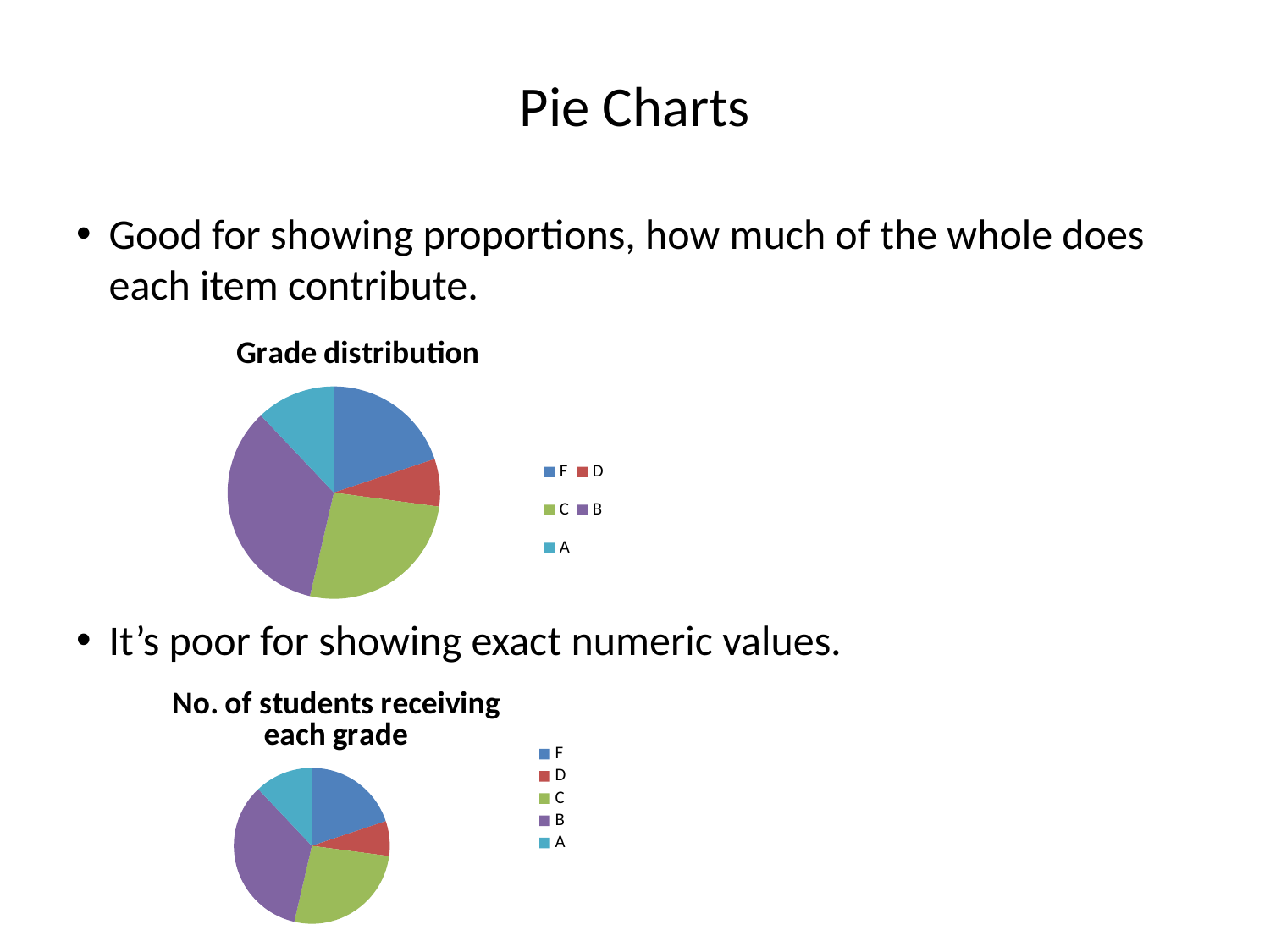
In the "Grade distribution" chart, how many slices does the pie have? 5 In the "No. of students receiving each grade" chart, how many entries does the legend list? 5 In the "Grade distribution" chart, which slice is larger, C or D? C In the "Grade distribution" chart, which grade is shown in purple? B What kind of chart is the "Grade distribution" chart? pie chart In the "Grade distribution" chart, which grade has the largest slice? B In the "No. of students receiving each grade" chart, which grade has the largest slice? B In the "No. of students receiving each grade" chart, which slice is larger, B or A? B In the "No. of students receiving each grade" chart, which grade has the smallest slice? D What kind of chart is the "No. of students receiving each grade" chart? pie chart What is the title of the upper pie chart on the slide? Grade distribution In the "Grade distribution" chart, which grade has the smallest slice? D